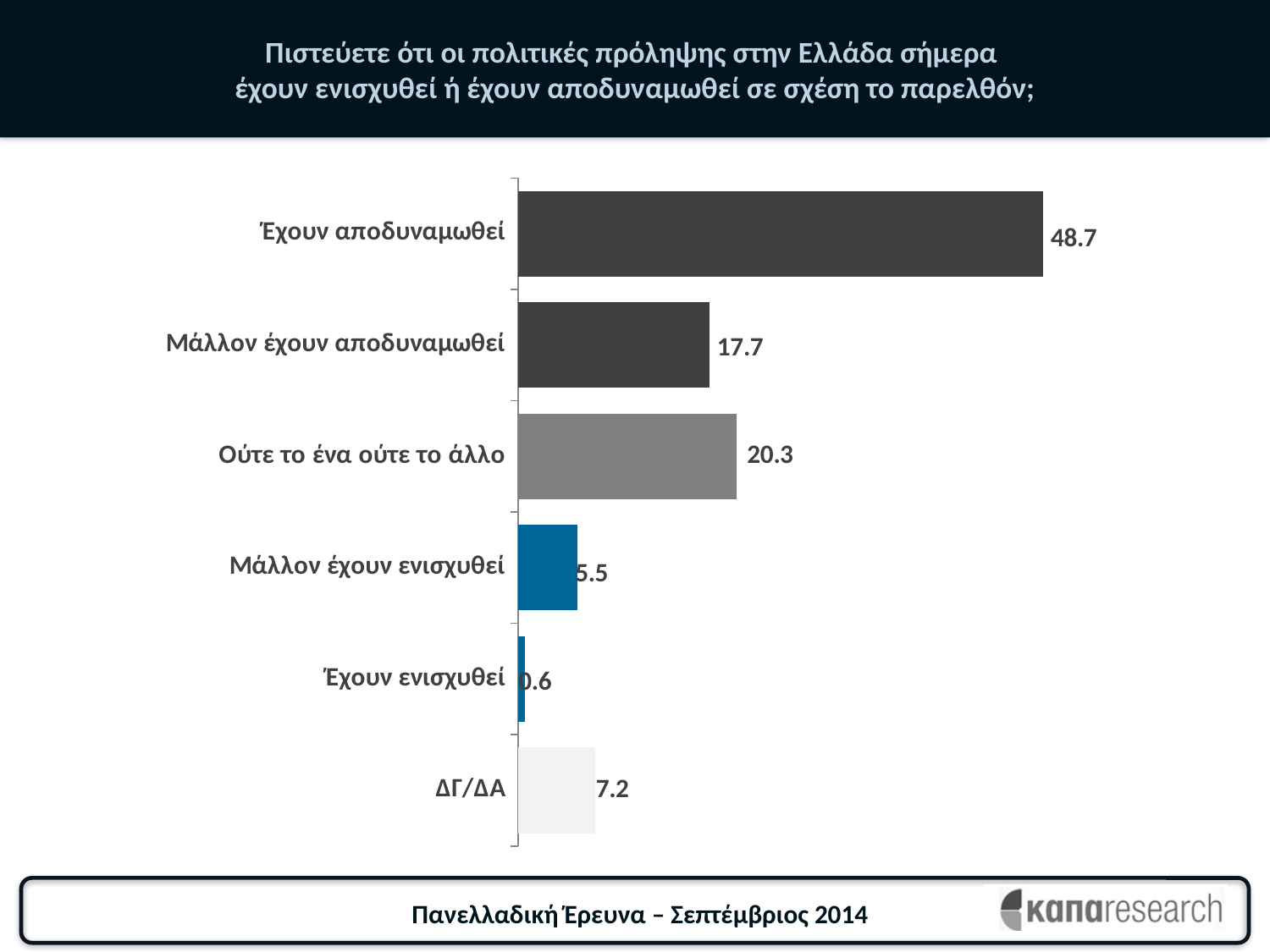
What is the value for "ΔΓ/ΔΑ"? 7.2 What is the value for "Ούτε το ένα ούτε το άλλο"? 20.3 What is the value for "Μάλλον έχουν ενισχυθεί"? 5.5 Which category has the highest value? Έχουν αποδυναμωθεί Which is larger: the value for "Ούτε το ένα ούτε το άλλο" or the value for "Μάλλον έχουν αποδυναμωθεί"? Ούτε το ένα ούτε το άλλο How many categories are shown in the chart? 6 What is the value for "Μάλλον έχουν αποδυναμωθεί"? 17.7 What is the value for "Έχουν αποδυναμωθεί"? 48.7 What kind of chart is shown on the slide? Bar chart What is the difference between the values for "ΔΓ/ΔΑ" and "Μάλλον έχουν ενισχυθεί"? 1.7 Which category has the lowest value? Έχουν ενισχυθεί What is the difference between the values for "Έχουν αποδυναμωθεί" and "Μάλλον έχουν αποδυναμωθεί"? 31.0